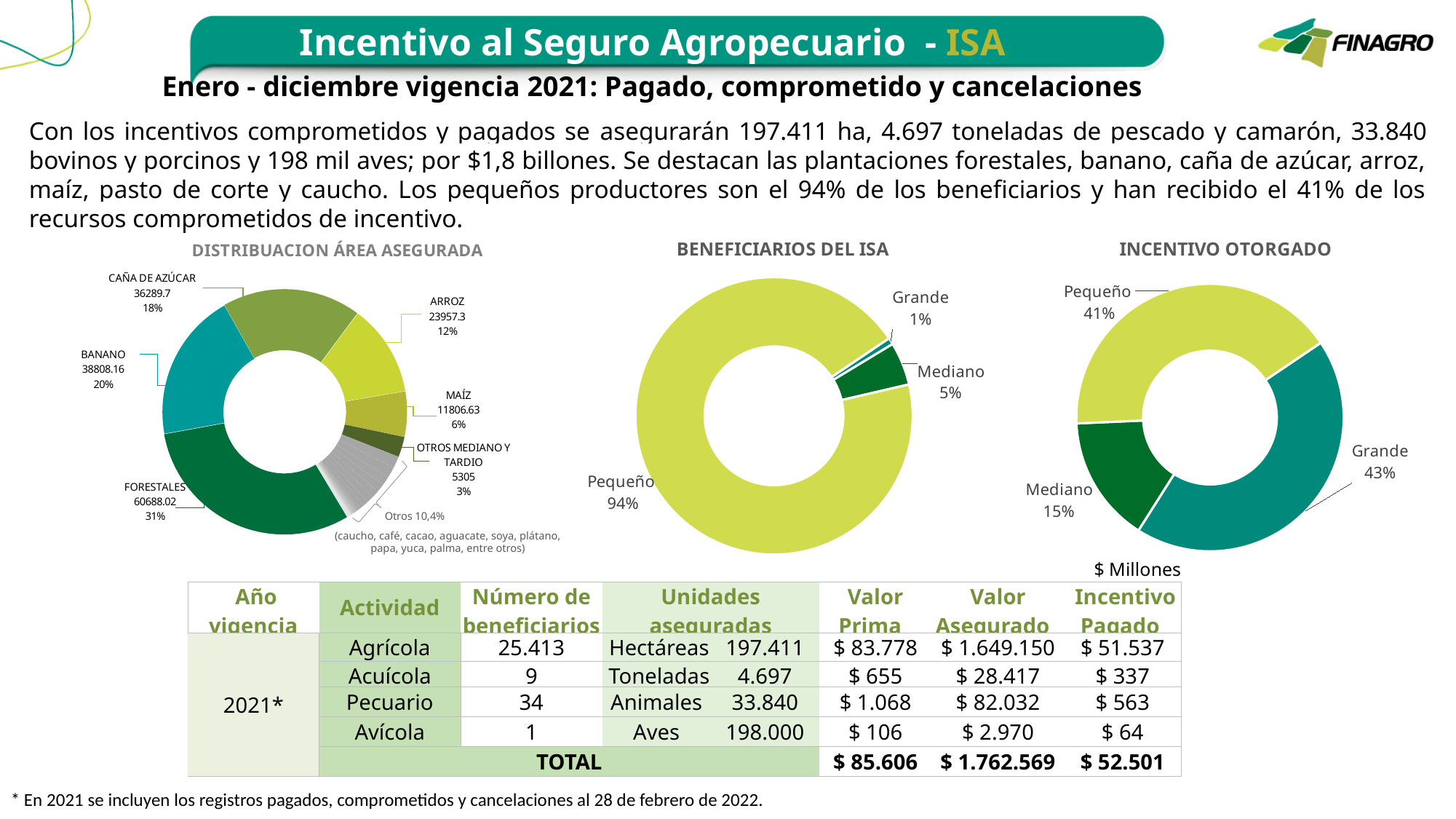
In the DISTRIBUACION ÁREA ASEGURADA chart, which labelled category has the largest share? FORESTALES In the DISTRIBUACION ÁREA ASEGURADA chart, what value is shown for FORESTALES? 60688.02 What kind of chart is BENEFICIARIOS DEL ISA? Donut (pie) chart In the INCENTIVO OTORGADO chart, what is the difference in percentage points between Grande and Pequeño? 2 In the INCENTIVO OTORGADO chart, which category has the smallest share? Mediano In the DISTRIBUACION ÁREA ASEGURADA chart, what share of the area does BANANO represent? 20% In the DISTRIBUACION ÁREA ASEGURADA chart, what is the difference between the values for CAÑA DE AZÚCAR and ARROZ? 12332.4 In the INCENTIVO OTORGADO chart, what share is shown for Grande? 43% In the DISTRIBUACION ÁREA ASEGURADA chart, which labelled category has the smallest share? OTROS MEDIANO Y TARDIO In the BENEFICIARIOS DEL ISA chart, what share do Pequeño beneficiaries represent? 94% In the DISTRIBUACION ÁREA ASEGURADA chart, which is larger, the value for MAÍZ or the value for ARROZ? ARROZ In the BENEFICIARIOS DEL ISA chart, how many categories are shown? 3